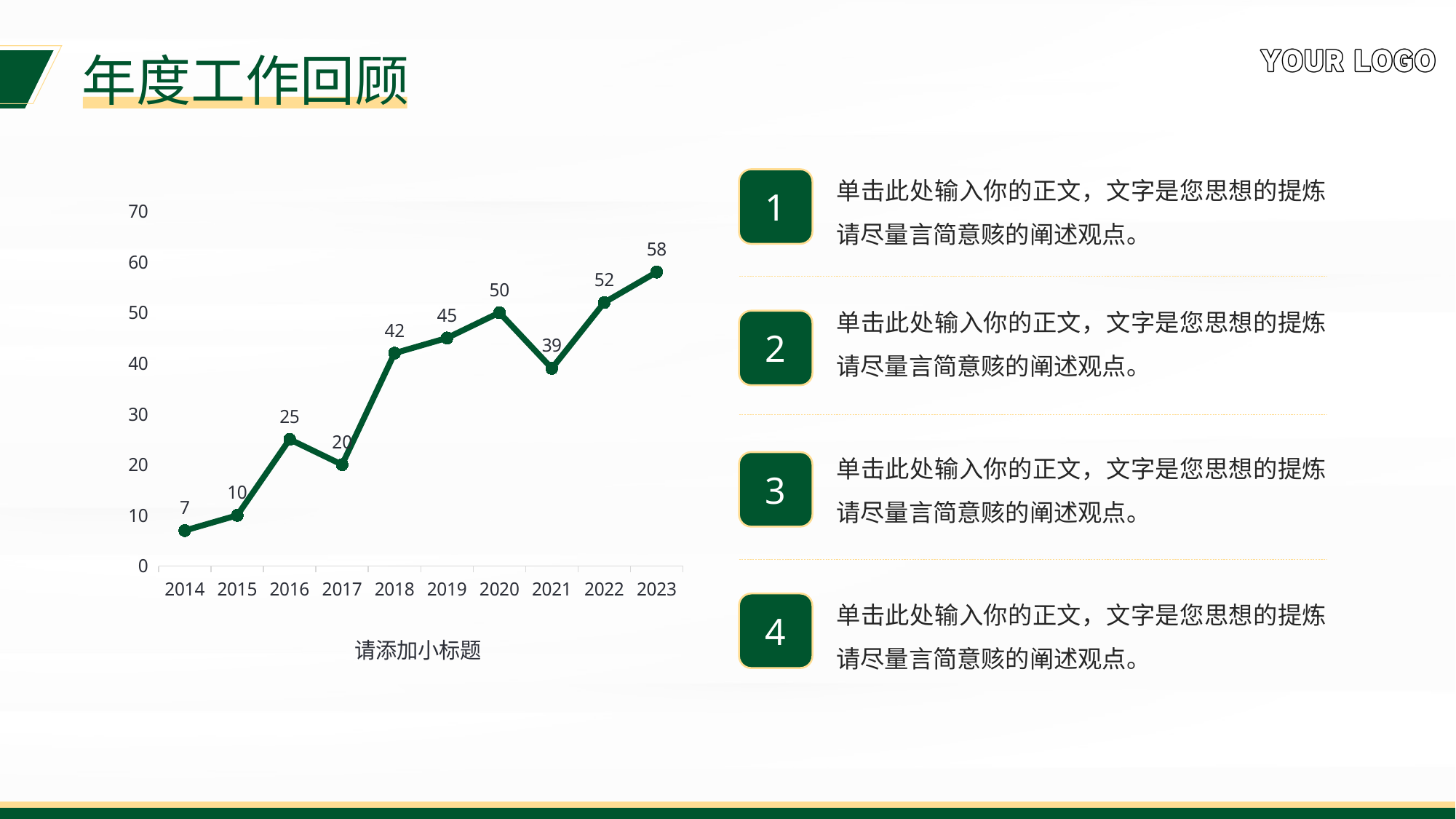
What is the difference between the values for 2023 and 2022? 6 What is the value for 2014? 7 Do the values generally rise or fall from 2014 to 2023? rise What is the value for 2021? 39 What kind of chart is shown on the slide? line chart What is the value for 2018? 42 Which year has the highest value? 2023 What is the difference between the values for 2020 and 2021? 11 Which is larger, the value for 2016 or the value for 2017? 2016 Which year has the lowest value? 2014 Is the value for 2019 greater or less than 40? greater How many years are plotted on the chart? 10